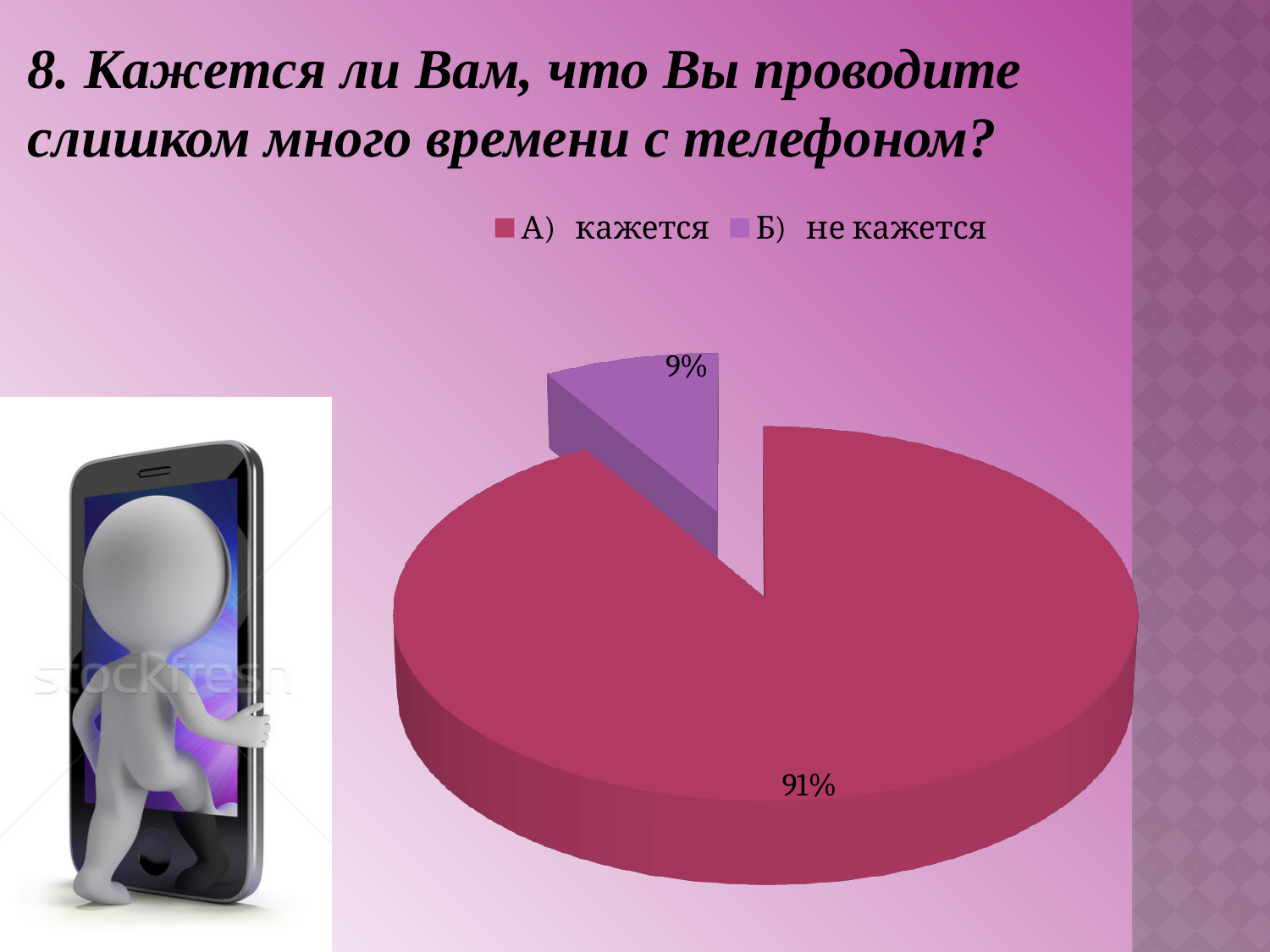
What is the difference in percentage points between "А) кажется" and "Б) не кажется"? 82 How many entries does the legend list? 2 Which is larger: the slice for "А) кажется" or the slice for "Б) не кажется"? А) кажется What kind of chart is shown on the slide? pie chart What colour is the slice for "Б) не кажется"? purple Which category has the largest slice of the pie? А) кажется How many slices does the pie chart have? 2 Which category has the smallest slice of the pie? Б) не кажется What is the title of the slide above the chart? 8. Кажется ли Вам, что Вы проводите слишком много времени с телефоном? What share of the pie does "Б) не кажется" take? 9% What share of the pie does "А) кажется" take? 91%